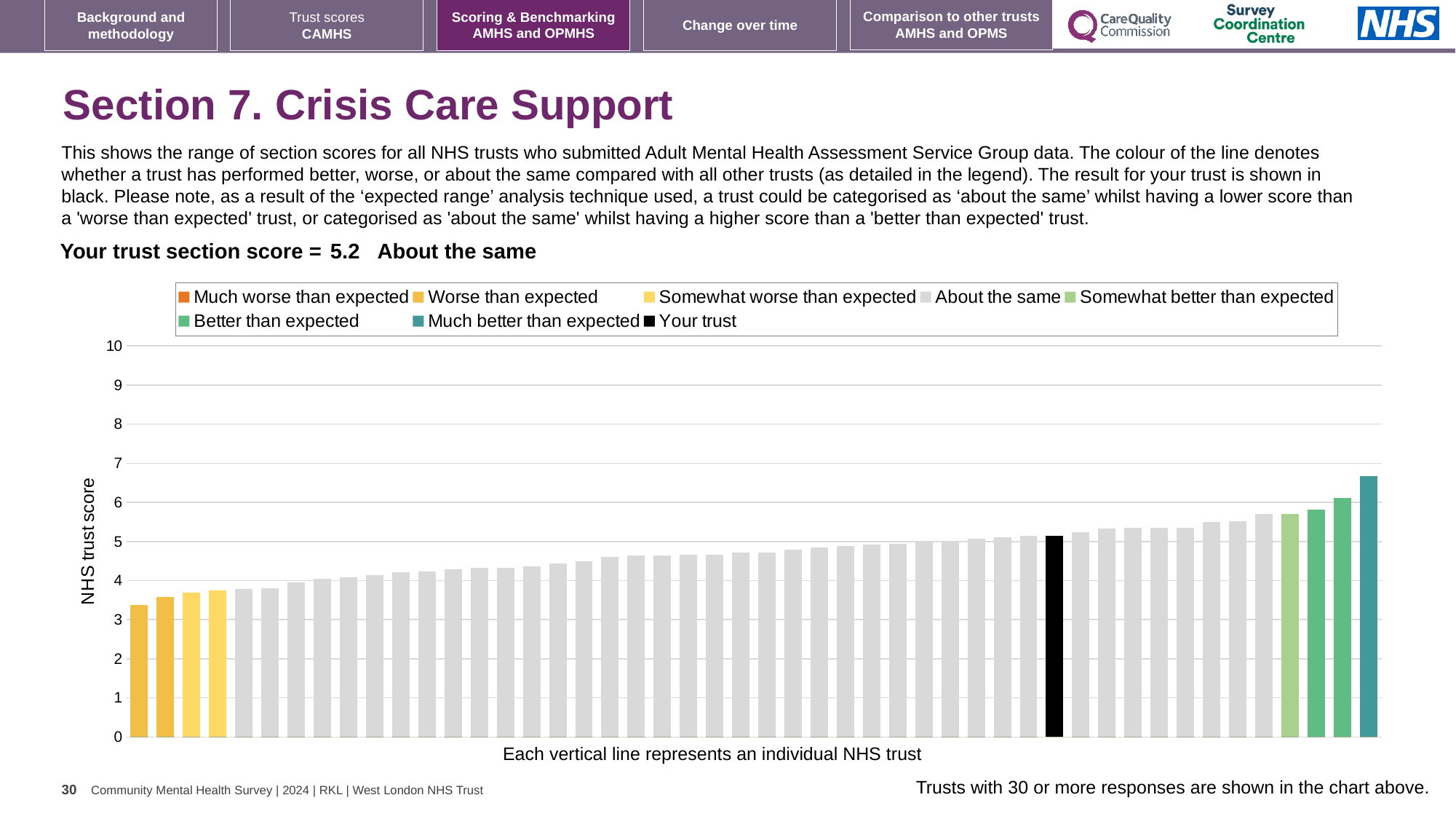
Do the bar values rise or fall from left to right along the x axis? rise How many entries does the chart legend list? 8 Is the value of the highest bar in the chart greater or less than 6? greater Which legend category does the lowest bar in the chart belong to? Worse than expected Which is larger, the score of your trust (black bar) or the score of the 'Much better than expected' trust (teal bar)? Much better than expected trust What is the section score for your trust (the black bar)? 5.2 What kind of chart is shown on the slide? bar chart What is the label on the vertical axis of the chart? NHS trust score Is the value for your trust (the black bar) greater or less than 5? greater How many bars are coloured as 'Much better than expected'? 1 Which legend category does the highest bar in the chart belong to? Much better than expected Is the value of the lowest bar in the chart greater or less than 4? less